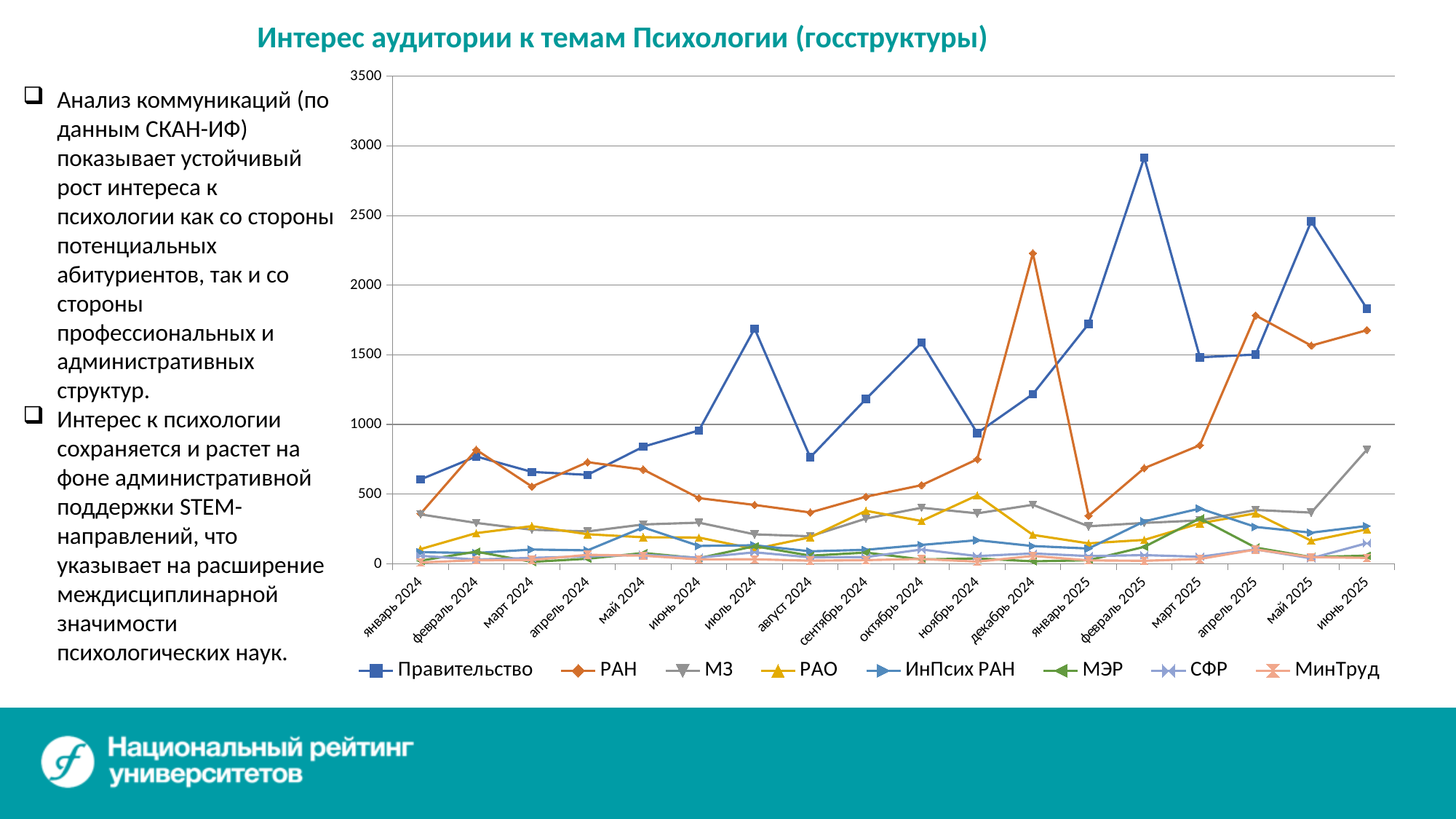
How many months are shown along the x axis? 18 In which month does the РАН series reach its highest value? декабрь 2024 Is the value for Правительство in февраль 2025 greater or less than 2500? greater What is the title of the chart? Интерес аудитории к темам Психологии (госструктуры) In which month does the Правительство series reach its highest value? февраль 2025 Is the value for МЗ in июнь 2025 greater or less than 500? greater How many series does the legend list? 8 Does the Правительство series rise or fall from апрель 2024 to июнь 2024? rise What kind of chart is shown on the slide? line chart In декабрь 2024, which series has the higher value, Правительство or РАН? РАН Is the value for Правительство in январь 2024 greater or less than 1000? less